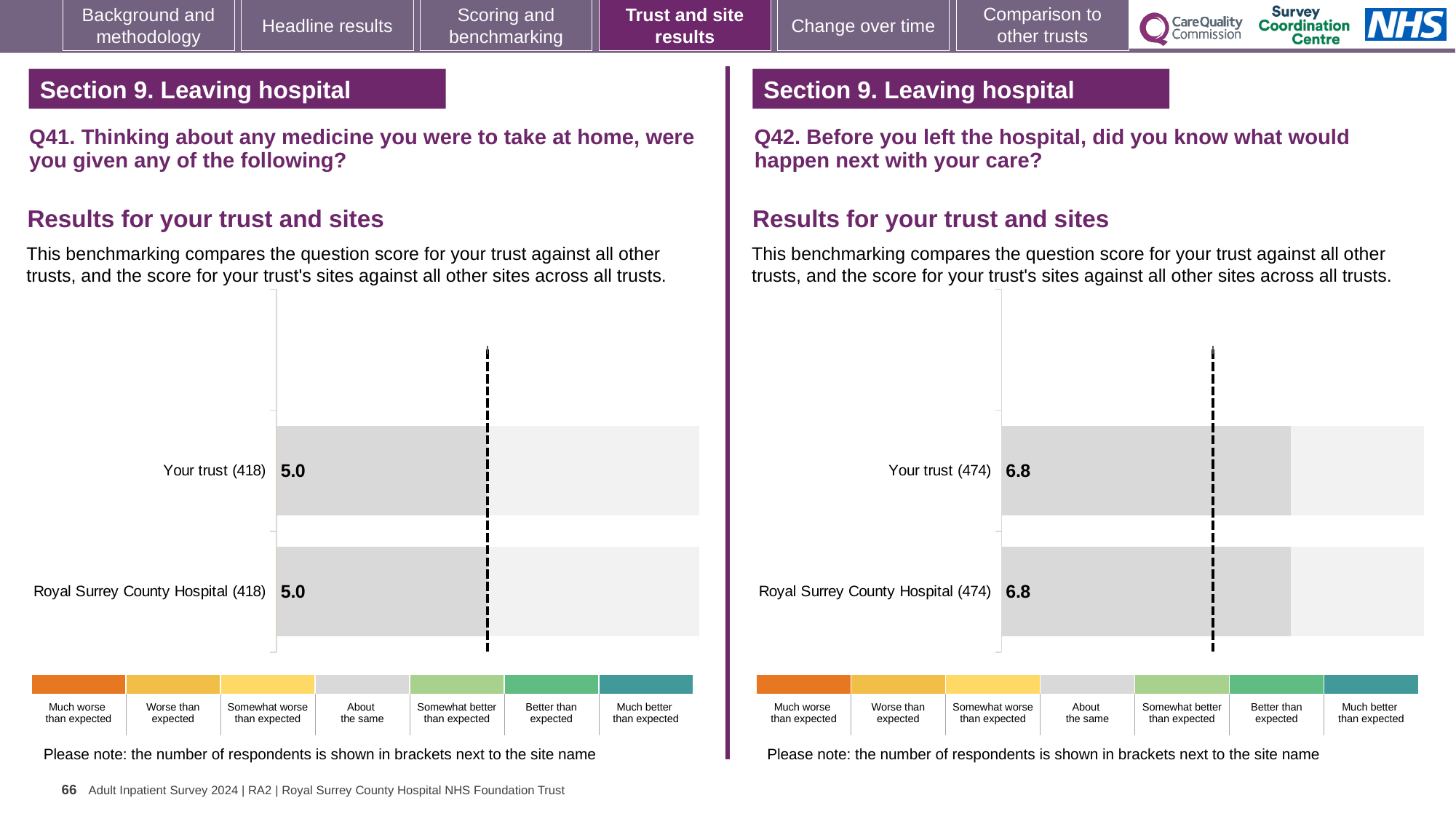
What type of chart is used in the Q41 chart on the left? Bar chart In the Q41 chart on the left, what is the score for Royal Surrey County Hospital? 5.0 Is the Your trust score in the Q42 chart on the right larger or smaller than the Your trust score in the Q41 chart on the left? Larger In the Q41 chart on the left, what is the difference between the score for Your trust and the score for Royal Surrey County Hospital? 0.0 In the Q42 chart on the right, what is the score for Royal Surrey County Hospital? 6.8 In the Q42 chart on the right, what is the score for Your trust? 6.8 In the Q41 chart on the left, what is the score for Your trust? 5.0 In the Q42 chart on the right, how many bars are plotted? 2 In the Q41 chart on the left, how many respondents are shown in brackets for Your trust? 418 How many categories does the colour key below the Q41 chart on the left list? 7 Which section heading appears above both charts on the slide? Section 9. Leaving hospital In the Q42 chart on the right, how many respondents are shown in brackets for Royal Surrey County Hospital? 474